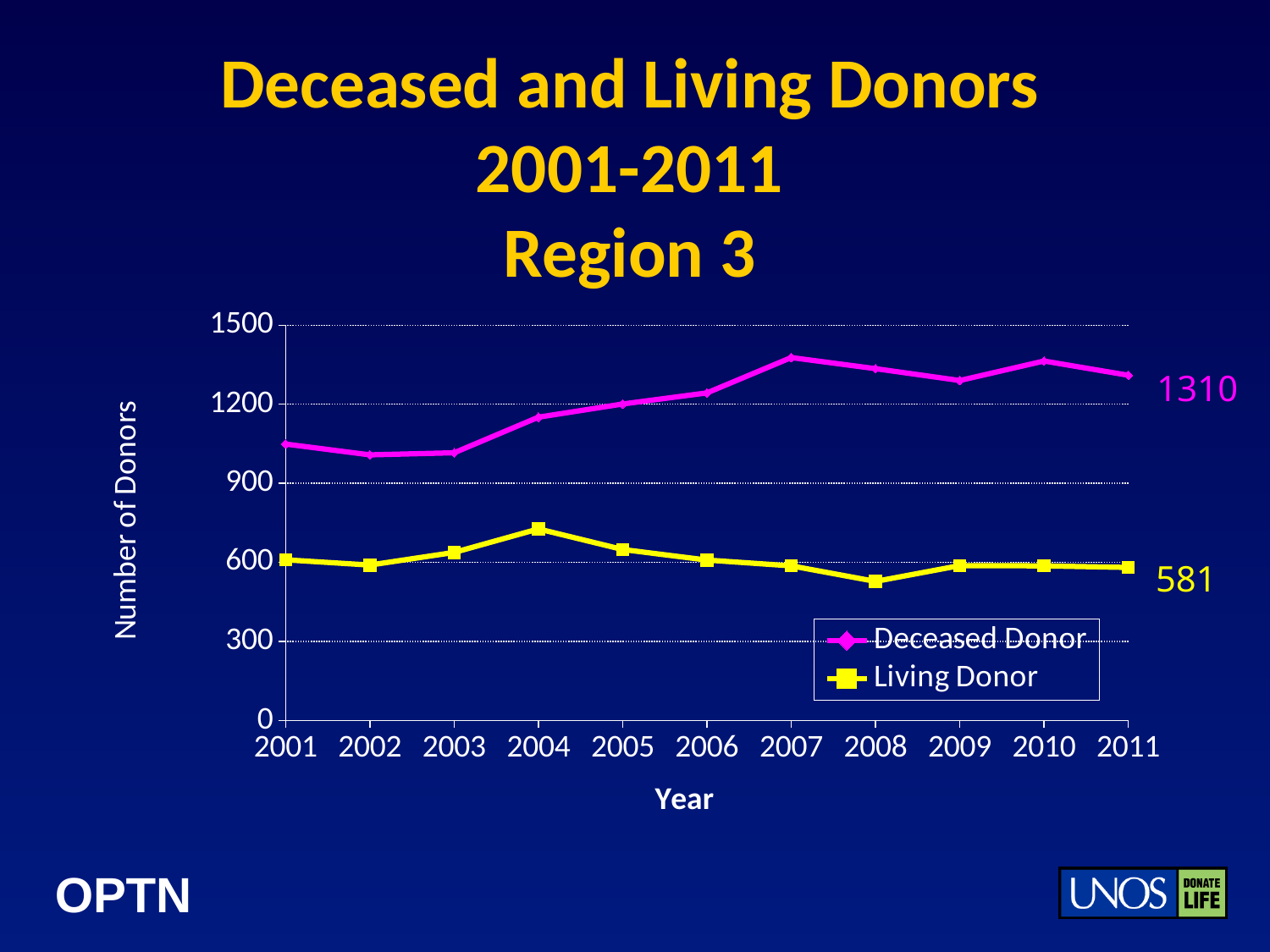
Which colour is used for the Living Donor line? Yellow What kind of chart is shown on the slide? Line chart Is the Living Donor value for 2004 greater or less than 600? greater In which year is the Living Donor value lowest? 2008 In which year is the Living Donor value highest? 2004 Is the Deceased Donor value for 2001 greater or less than 1200? less How many years are plotted along the x axis? 11 What is the number of Deceased Donors in 2011? 1310 What is the number of Living Donors in 2011? 581 What is the difference between the Deceased Donor and Living Donor values in 2011? 729 Which series has the larger value in 2011, Deceased Donor or Living Donor? Deceased Donor How many series does the legend list? 2